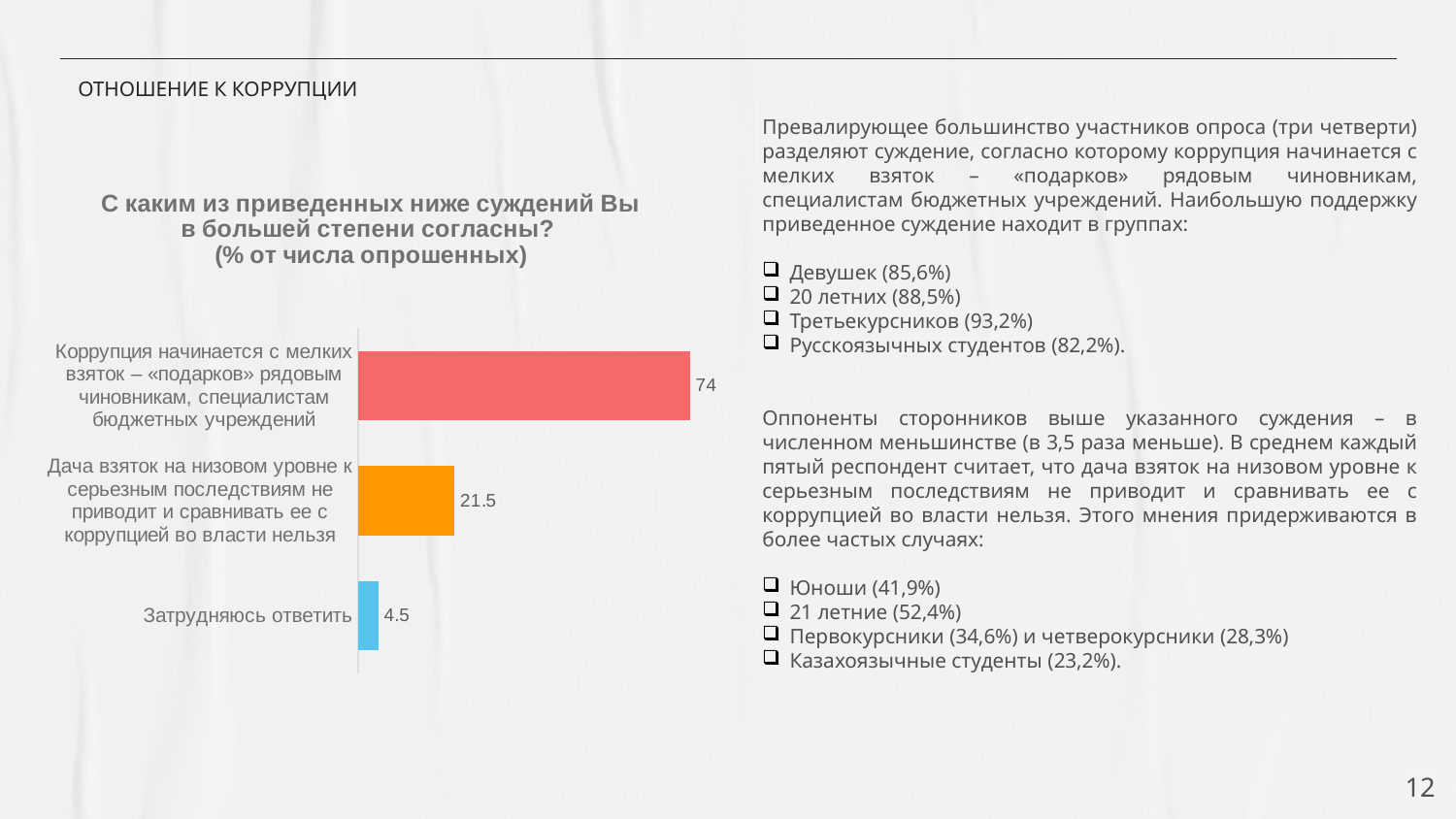
Which category has the highest value in the chart? Коррупция начинается с мелких взяток – «подарков» рядовым чиновникам, специалистам бюджетных учреждений What value is shown for the category "Затрудняюсь ответить"? 4.5 What value is shown for the category "Дача взяток на низовом уровне к серьезным последствиям не приводит и сравнивать ее с коррупцией во власти нельзя"? 21.5 Which category has the lowest value in the chart? Затрудняюсь ответить What value is shown for the category "Коррупция начинается с мелких взяток – «подарков» рядовым чиновникам, специалистам бюджетных учреждений"? 74 Which is larger: the value for "Дача взяток на низовом уровне..." or the value for "Затрудняюсь ответить"? Дача взяток на низовом уровне к серьезным последствиям не приводит и сравнивать ее с коррупцией во власти нельзя How many categories are shown in the chart? 3 What is the title of the chart? С каким из приведенных ниже суждений Вы в большей степени согласны? (% от числа опрошенных) What colour is the bar for "Затрудняюсь ответить"? Blue What is the difference between the value for "Коррупция начинается с мелких взяток..." and the value for "Дача взяток на низовом уровне..."? 52.5 What is the difference between the value for "Дача взяток на низовом уровне..." and the value for "Затрудняюсь ответить"? 17 What kind of chart is shown on the slide? Bar chart